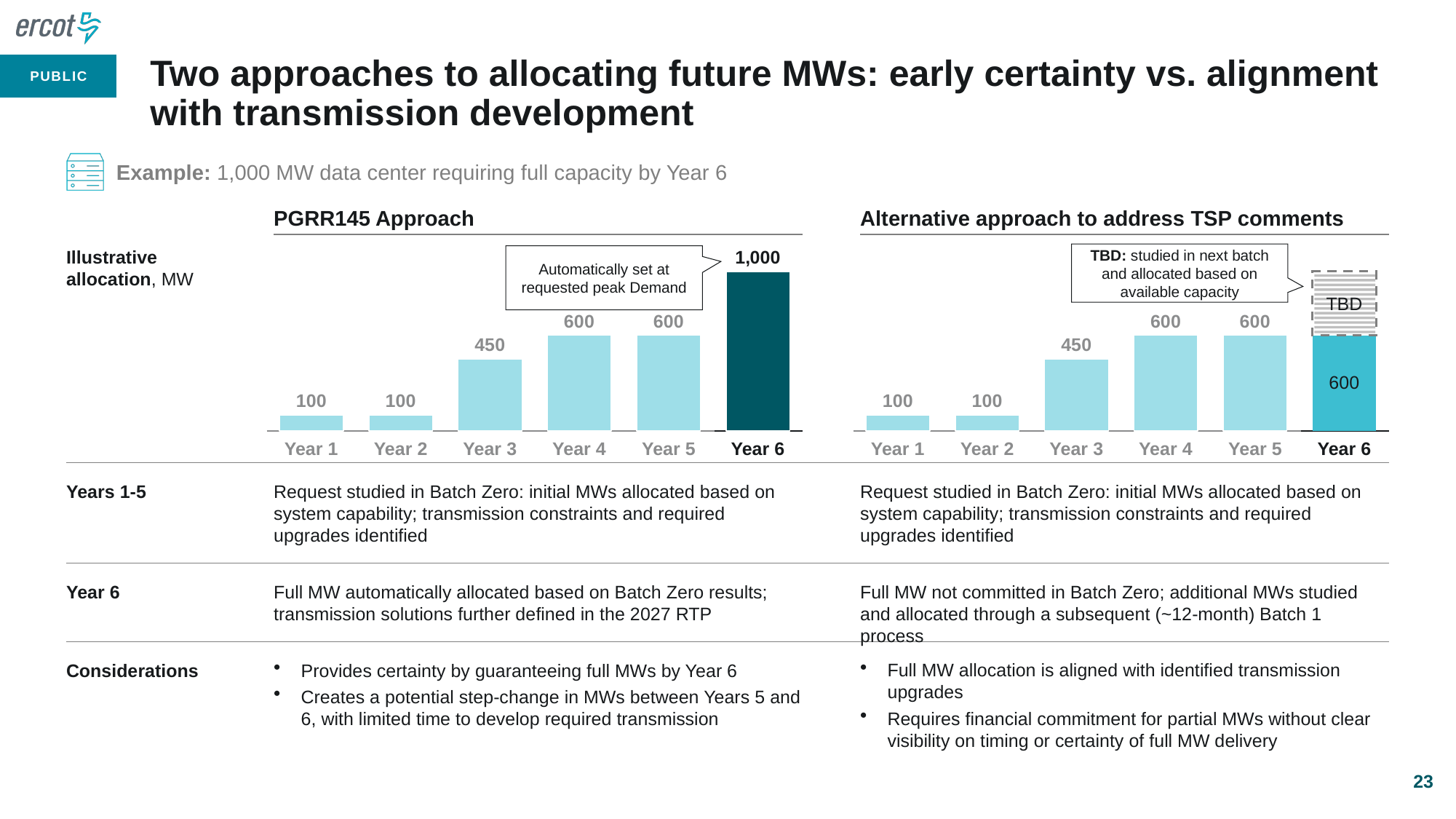
In the PGRR145 Approach chart, which year has the highest allocation? Year 6 In the Alternative approach chart, which is larger, the value for Year 3 or the value for Year 4? Year 4 In the PGRR145 Approach chart, what is the value for Year 3? 450 What kind of chart is the Alternative approach to address TSP comments chart? Bar chart How many years (categories) are shown on the x axis of the PGRR145 Approach chart? 6 In the Alternative approach chart, what label is shown on the hatched portion above the Year 6 bar? TBD In the Alternative approach chart, what is the value for Year 1? 100 In the PGRR145 Approach chart, what is the illustrative allocation for Year 6? 1,000 In the Alternative approach chart, what is the committed value shown for Year 6? 600 In the PGRR145 Approach chart, do the values rise or fall from Year 1 to Year 6? Rise In the PGRR145 Approach chart, what is the difference between the Year 6 and Year 5 values? 400 In the PGRR145 Approach chart, what is the difference between the Year 3 and Year 2 values? 350